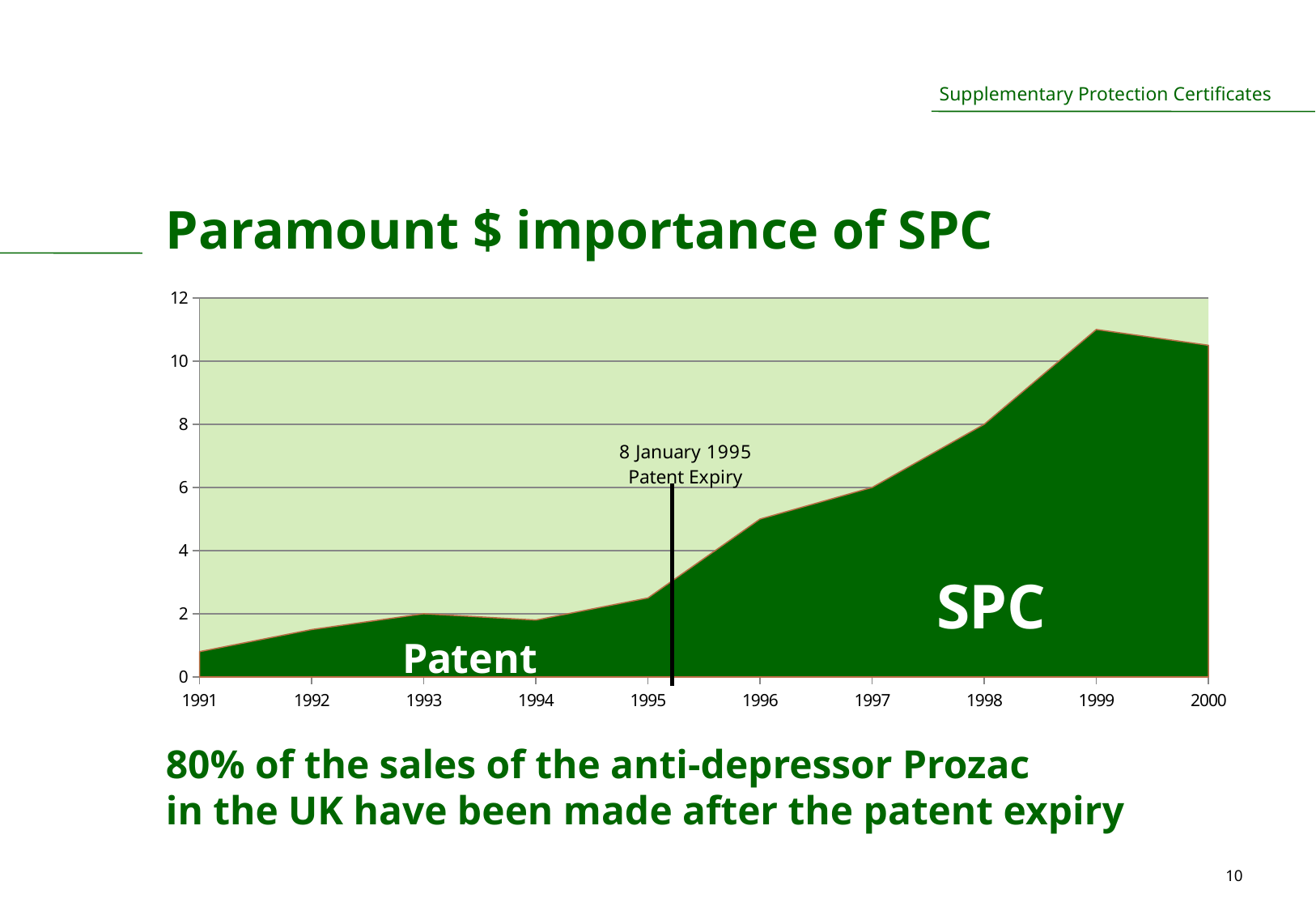
What is the title of the chart slide? Paramount $ importance of SPC What kind of chart is shown on the slide? area chart Is the value for 1991 greater or less than 2? less Which year has the highest value in the chart? 1999 Which year has the lowest value in the chart? 1991 Is the value for 1996 greater or less than 4? greater How many years are shown on the x axis of the chart? 10 Is the value for 1999 greater or less than 10? greater Which year has the larger value, 1998 or 1994? 1998 What event does the vertical black line in the chart mark? 8 January 1995 Patent Expiry Do the values generally rise or fall from 1991 to 1999? rise